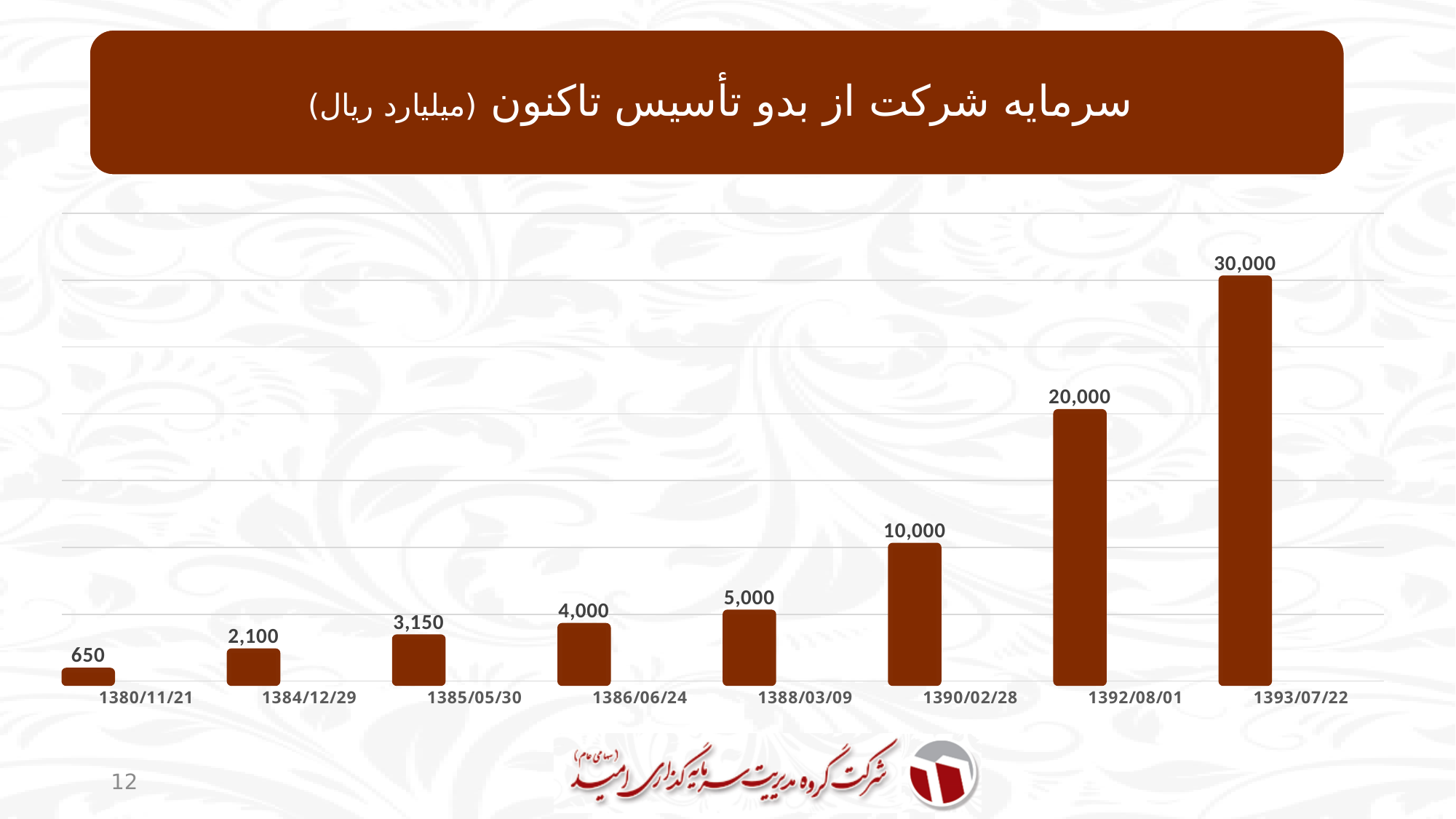
How many bars are shown in the chart? 8 What is the value for 1386/06/24? 4,000 Which is larger, the value for 1388/03/09 or the value for 1390/02/28? 1390/02/28 What is the difference between the values for 1393/07/22 and 1392/08/01? 10,000 Which date has the highest value? 1393/07/22 Which date has the lowest value? 1380/11/21 What is the difference between the values for 1385/05/30 and 1384/12/29? 1,050 What kind of chart is shown on the slide? Bar chart Do the values rise or fall from left to right along the x axis? Rise What colour are the bars in the chart? Brown What is the value for 1380/11/21? 650 What is the value for 1392/08/01? 20,000